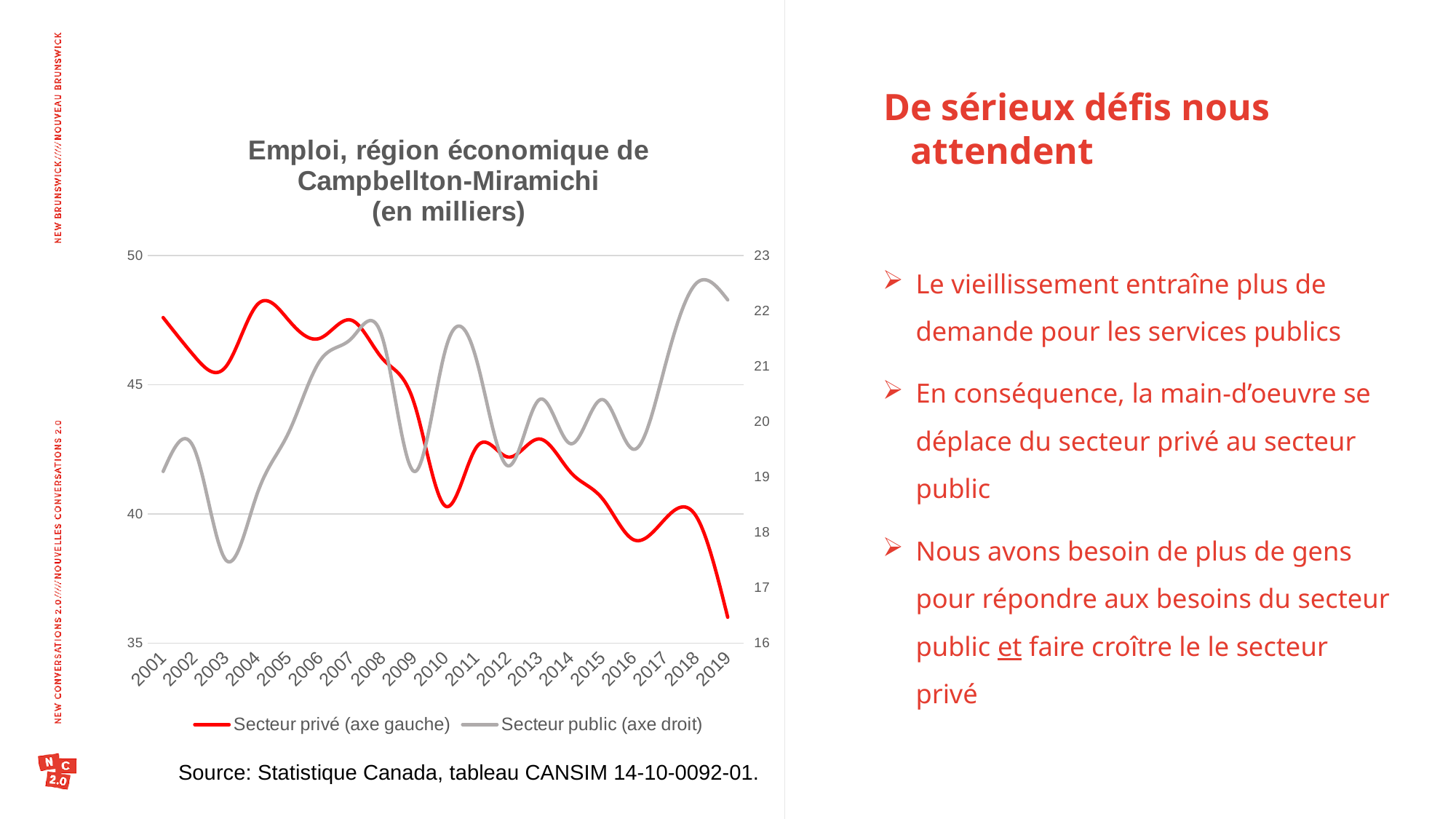
Is the value for Secteur privé in 2004 greater or less than 45? greater Is the value for Secteur privé in 2019 greater or less than 40? less Which year has the lowest value for Secteur privé? 2019 What kind of chart is shown on the slide? Line chart Which axis is the Secteur public series plotted against, according to the legend? Axe droit (right axis) Which year has the highest value for Secteur public? 2018 Which year has the lowest value for Secteur public? 2003 Does the Secteur privé line overall rise or fall from 2001 to 2019? Fall Is the value for Secteur public in 2018 greater or less than 22? greater How many years are plotted along the x axis? 19 How many series does the legend list? 2